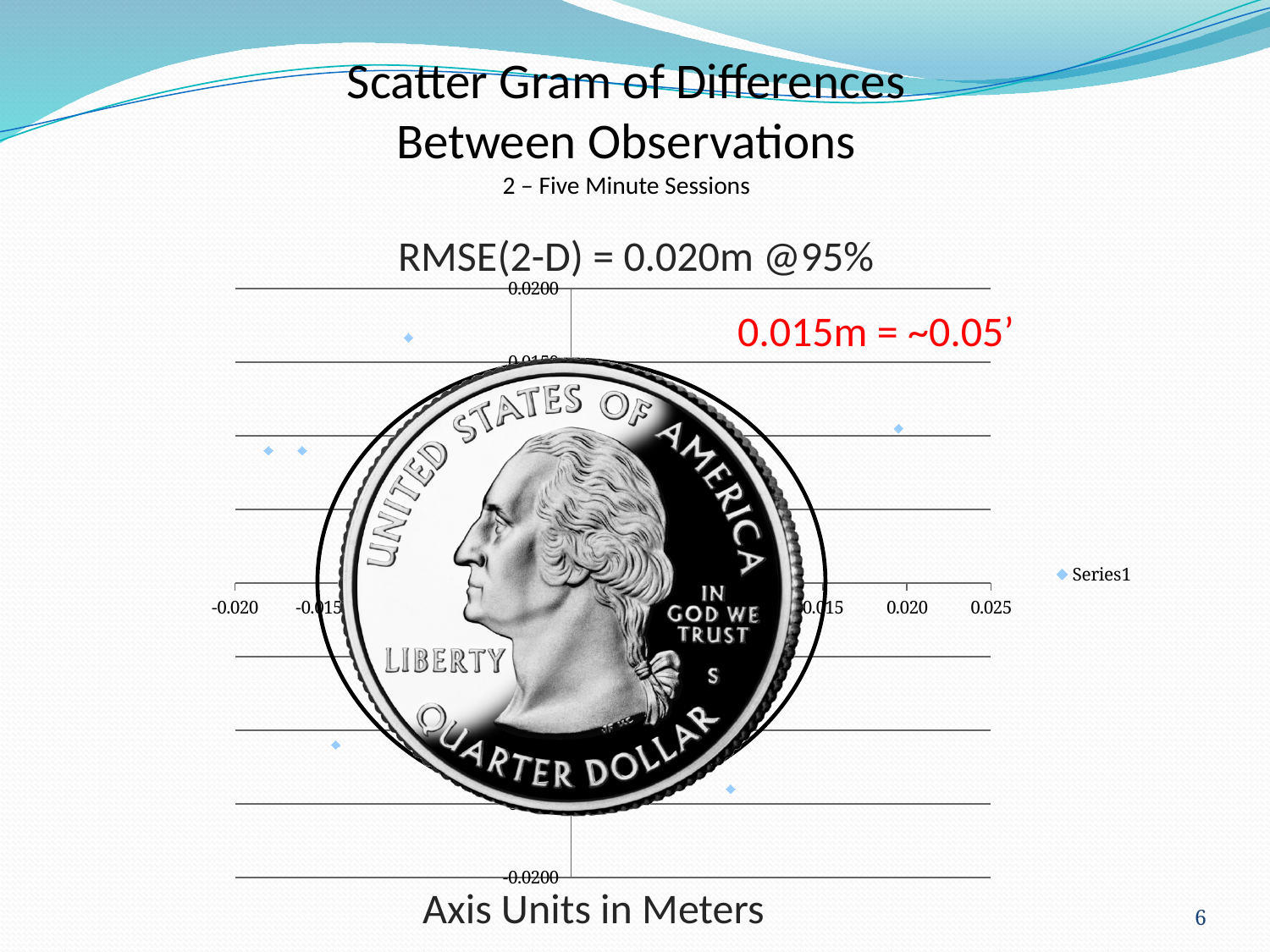
Is the x value of the rightmost plotted point greater or less than 0.025? less What kind of chart is shown on the slide? scatter chart How many series does the chart legend list? 1 Is the y value of the highest plotted point (upper left of the chart) greater or less than 0.0150? greater What is the name of the series shown in the chart legend? Series1 What is the title of the chart? RMSE(2-D) = 0.020m @95% Is the x value of the leftmost plotted point greater or less than -0.020? greater